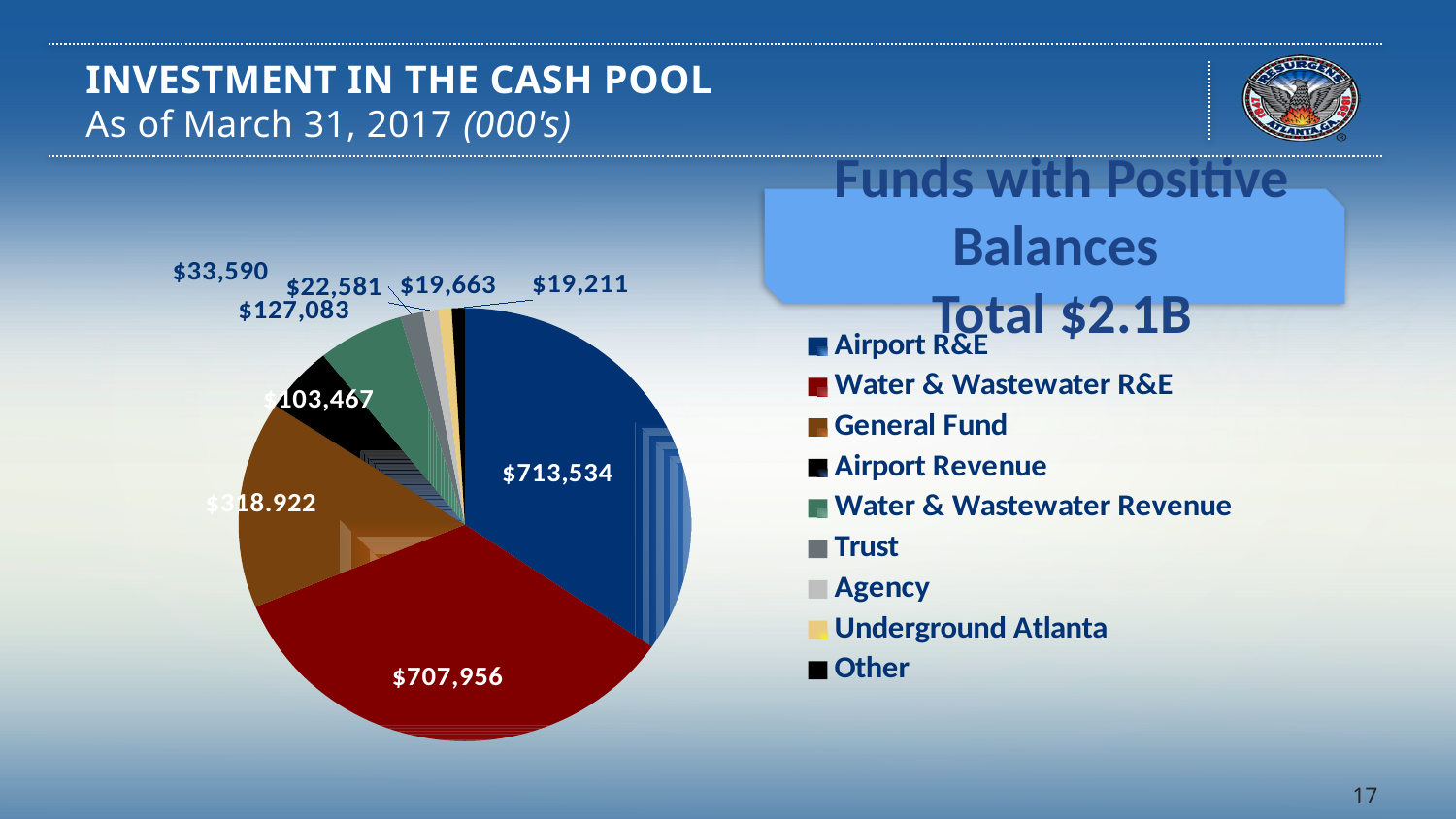
What is the value for Airport R&E in the pie chart? $713,534 What is the value for Water & Wastewater R&E in the pie chart? $707,956 How many slices does the pie chart have? 9 Which fund has the smallest slice in the pie chart? Other What total is stated for the funds with positive balances? $2.1B Which fund has the largest slice in the pie chart? Airport R&E What is the value for Trust in the pie chart? $33,590 Which is larger, Water & Wastewater Revenue or Airport Revenue? Water & Wastewater Revenue What type of chart is shown on the slide? pie chart What is the value for Water & Wastewater Revenue in the pie chart? $127,083 What is the value for Airport Revenue in the pie chart? $103,467 What is the difference between the Airport R&E value and the Water & Wastewater R&E value? $5,578